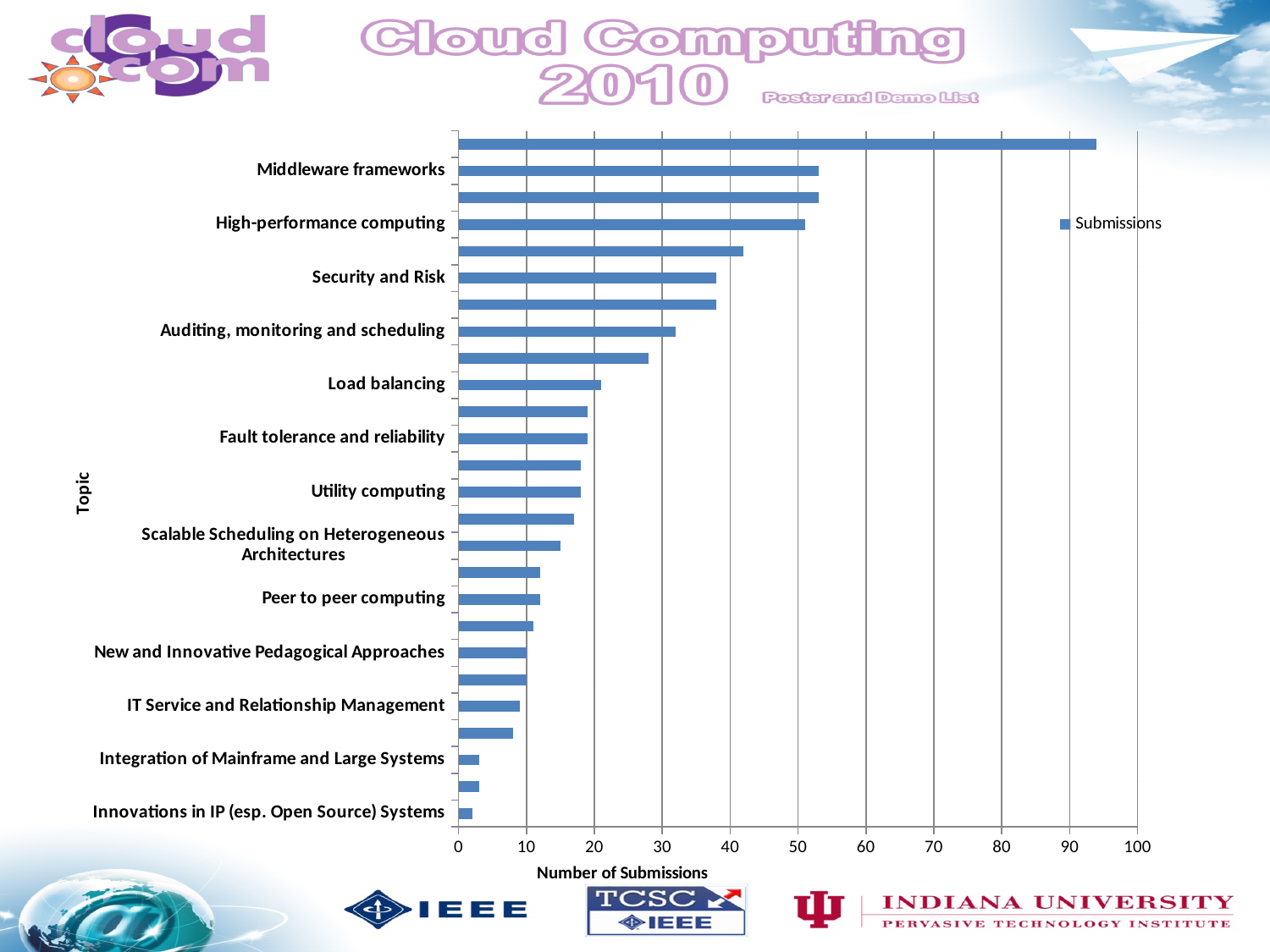
Which has more submissions, Middleware frameworks or Security and Risk? Middleware frameworks What is the title of the horizontal axis? Number of Submissions Which labeled topic has the lowest number of submissions? Innovations in IP (esp. Open Source) Systems What kind of chart is shown on the slide? Bar chart Is the value for Auditing, monitoring and scheduling greater or less than 30? greater Is the value for Security and Risk greater or less than 40? less How many series does the legend list? 1 Is the value for Innovations in IP (esp. Open Source) Systems greater or less than 10? less Which has more submissions, Load balancing or Peer to peer computing? Load balancing What is the name of the series shown in the legend? Submissions